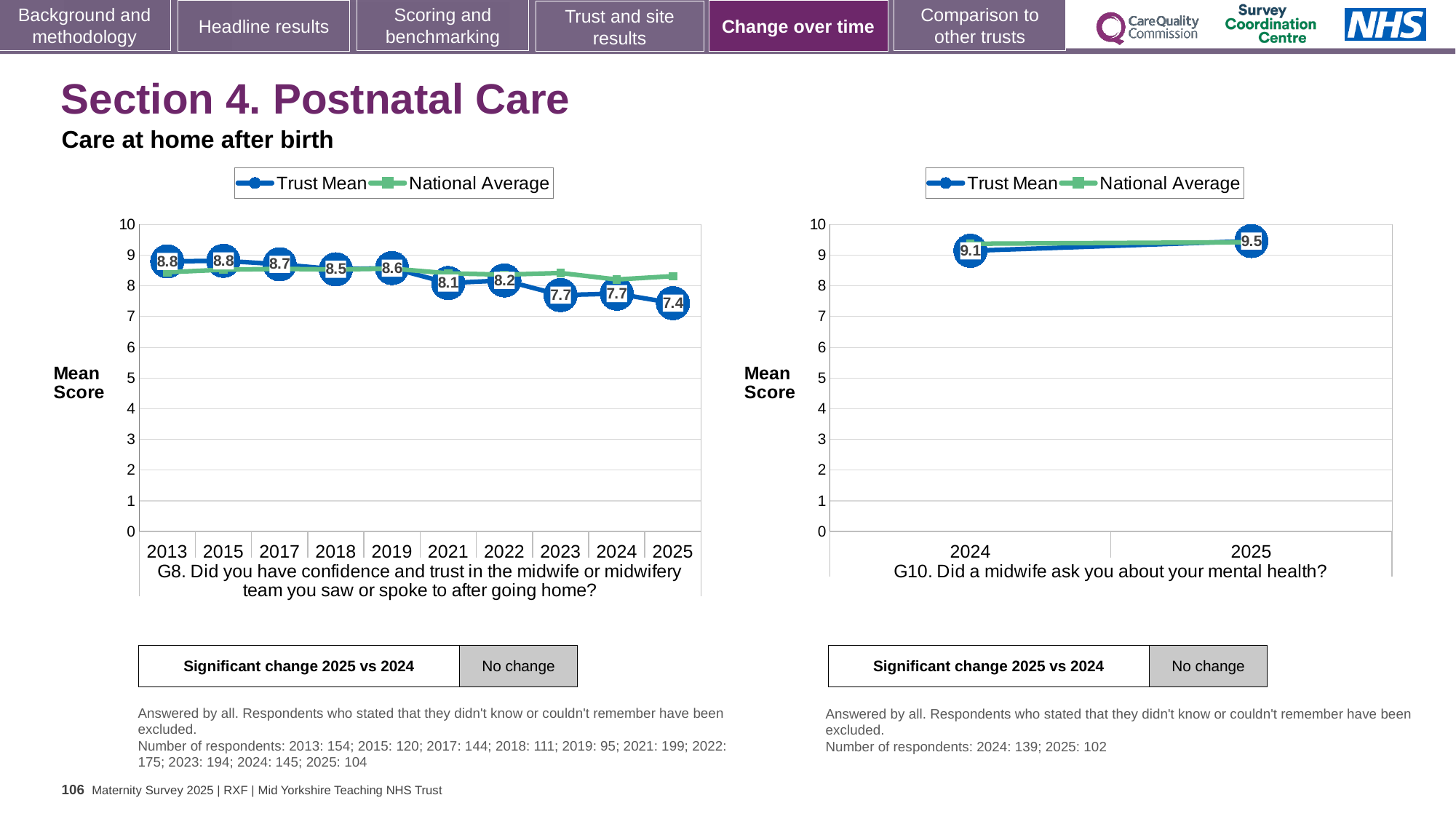
In the G10 chart (right), how many series does the legend list? 2 In the G8 chart (left), how many years are shown on the x axis? 10 In the G8 chart (left), what is the Trust Mean for 2013? 8.8 What type of chart is the G10 chart (right)? line chart In the G8 chart (left), what is the Trust Mean for 2025? 7.4 In the G10 chart (right), what is the Trust Mean for 2025? 9.5 In the G8 chart (left), what is the difference between the Trust Mean in 2013 and in 2025? 1.4 In the G8 chart (left), what is the Trust Mean for 2021? 8.1 In the G8 chart (left), which year has the lowest Trust Mean? 2025 In the G10 chart (right), what is the difference between the Trust Mean in 2025 and in 2024? 0.4 In the G8 chart (left), is the National Average for 2025 greater or less than 8? greater In the G8 chart (left), does the Trust Mean generally rise or fall from 2013 to 2025? fall